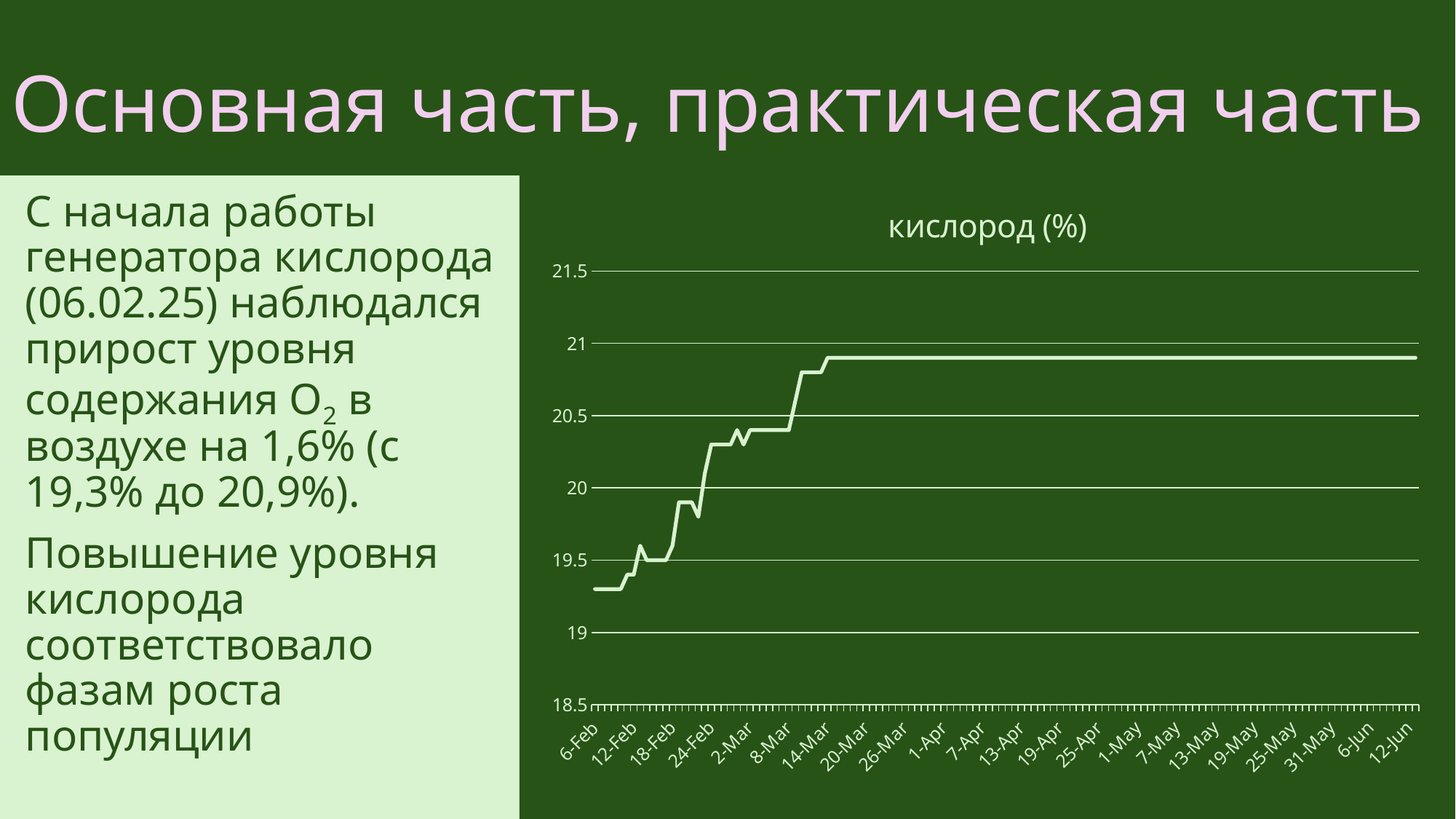
Which has the larger value, 6-Feb or 12-Jun? 12-Jun Is the value for 14-Mar greater or less than 20.5? greater What is the title of the chart? кислород (%) Is the value for 6-Feb greater or less than 19.5? less Do the values rise or fall along the x axis from 6-Feb to 14-Mar? rise Is the value for 24-Feb greater or less than 20? greater What is the highest value shown on the y axis? 21.5 Which has the larger value, 12-Feb or 24-Feb? 24-Feb What kind of chart is shown on the slide? line chart